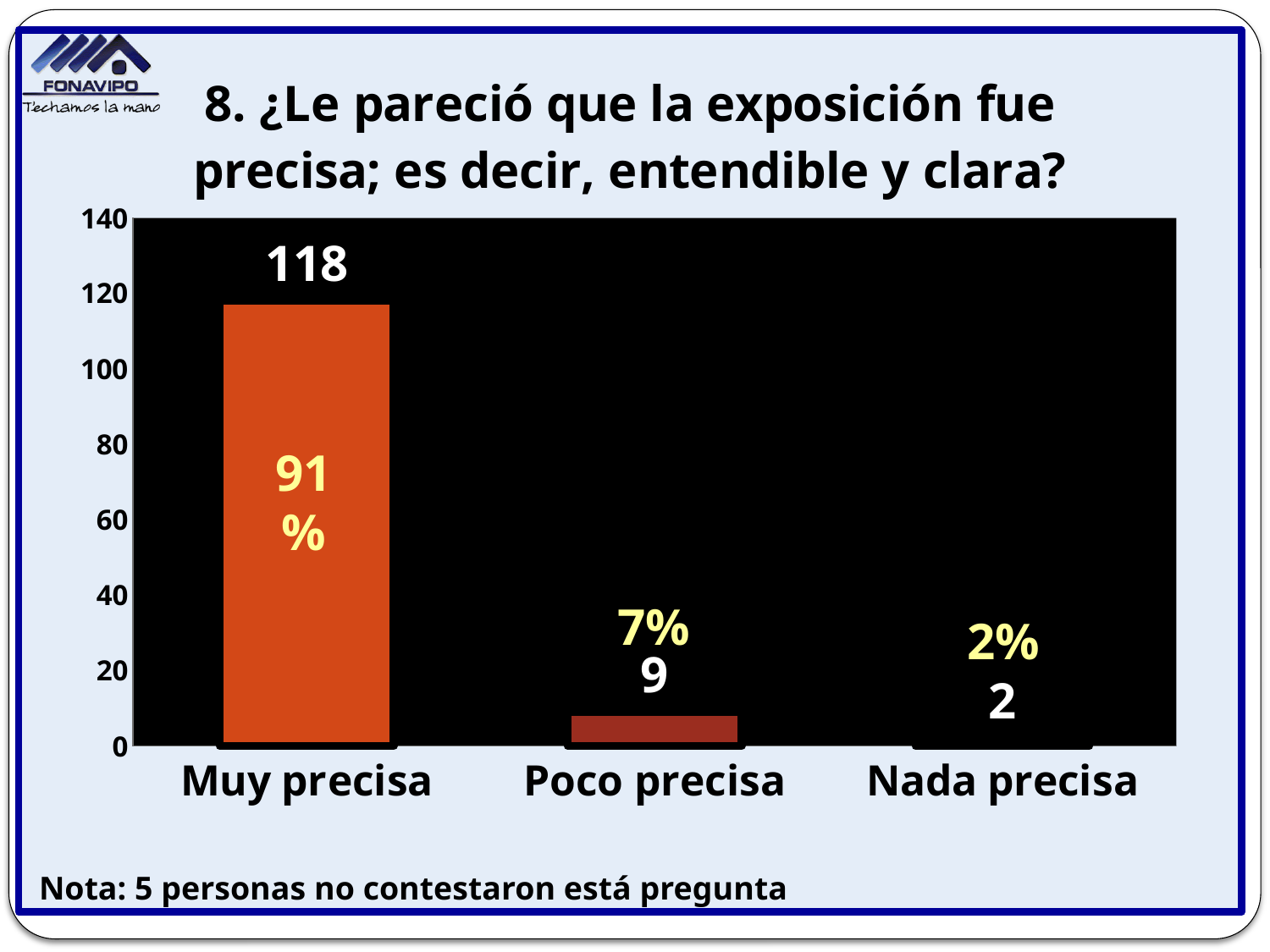
What percentage is shown for Muy precisa? 91% What percentage is shown for Poco precisa? 7% What kind of chart is shown on the slide? bar chart What is the value for Nada precisa? 2 Which category has the highest value? Muy precisa What is the value for Muy precisa? 118 How many categories are shown on the x axis? 3 Which category has the lowest value? Nada precisa What is the value for Poco precisa? 9 Is the value for Muy precisa greater or less than 100? greater What is the difference between the values for Muy precisa and Poco precisa? 109 Which is larger, the value for Poco precisa or the value for Nada precisa? Poco precisa